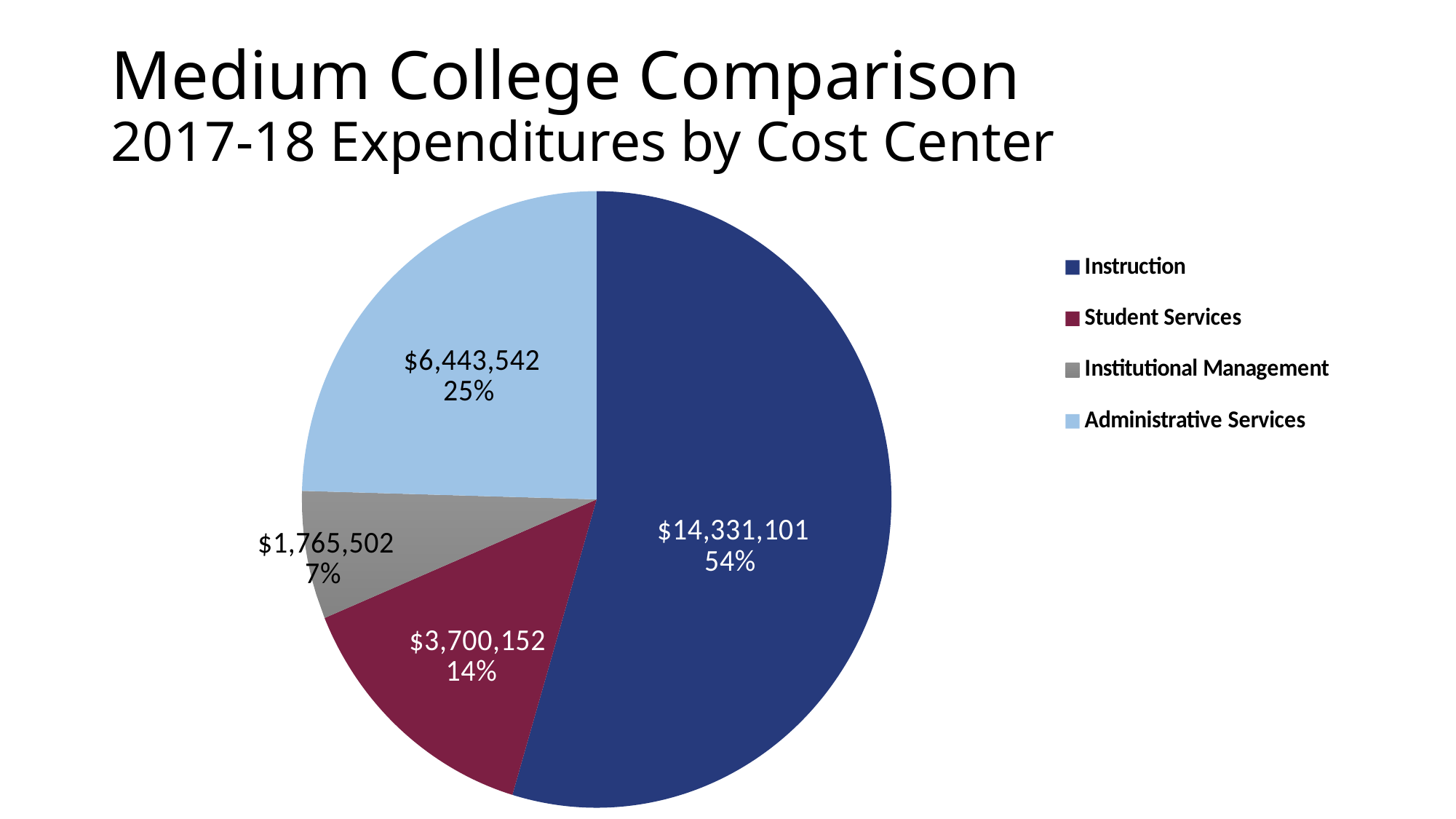
What share of the pie does Institutional Management represent? 7% Which cost center has the largest expenditure? Instruction Which cost center has the smallest expenditure? Institutional Management What is the expenditure value for Student Services? $3,700,152 What is the expenditure value for Administrative Services? $6,443,542 What is the expenditure value for Institutional Management? $1,765,502 What is the expenditure value for Instruction? $14,331,101 Which is larger, the expenditure for Student Services or for Administrative Services? Administrative Services What is the difference between the Instruction and Administrative Services expenditures? $7,887,559 What share of the pie does Administrative Services represent? 25% How many cost centers (slices) does the pie chart show? 4 What kind of chart is shown on the slide? Pie chart